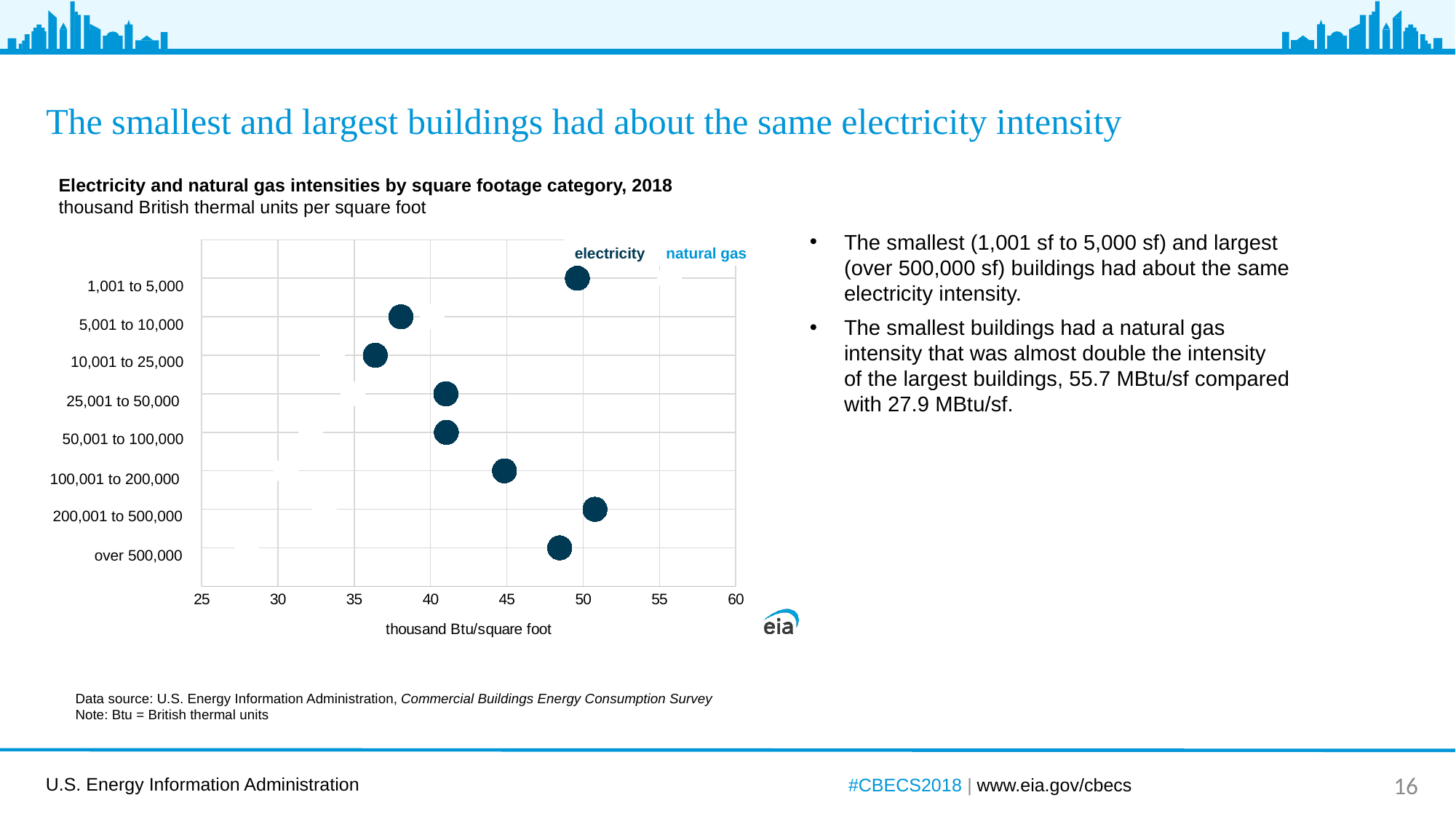
How many square footage categories are listed on the chart's vertical axis? 8 Which has the lower electricity intensity: buildings of 10,001 to 25,000 square feet or buildings of 100,001 to 200,000 square feet? 10,001 to 25,000 Is the electricity intensity for buildings of 1,001 to 5,000 square feet greater or less than 45 thousand Btu/square foot? greater What unit is shown on the chart's horizontal axis? thousand Btu/square foot What are the two series named in the chart's legend? electricity and natural gas Is the electricity intensity for buildings of 5,001 to 10,000 square feet greater or less than 35 thousand Btu/square foot? greater Is the electricity intensity for buildings over 500,000 square feet greater or less than 45 thousand Btu/square foot? greater Which has the higher electricity intensity: buildings of 1,001 to 5,000 square feet or buildings of 5,001 to 10,000 square feet? 1,001 to 5,000 How many series does the chart's legend list? 2 What kind of chart is shown on the slide? Scatter (dot) plot